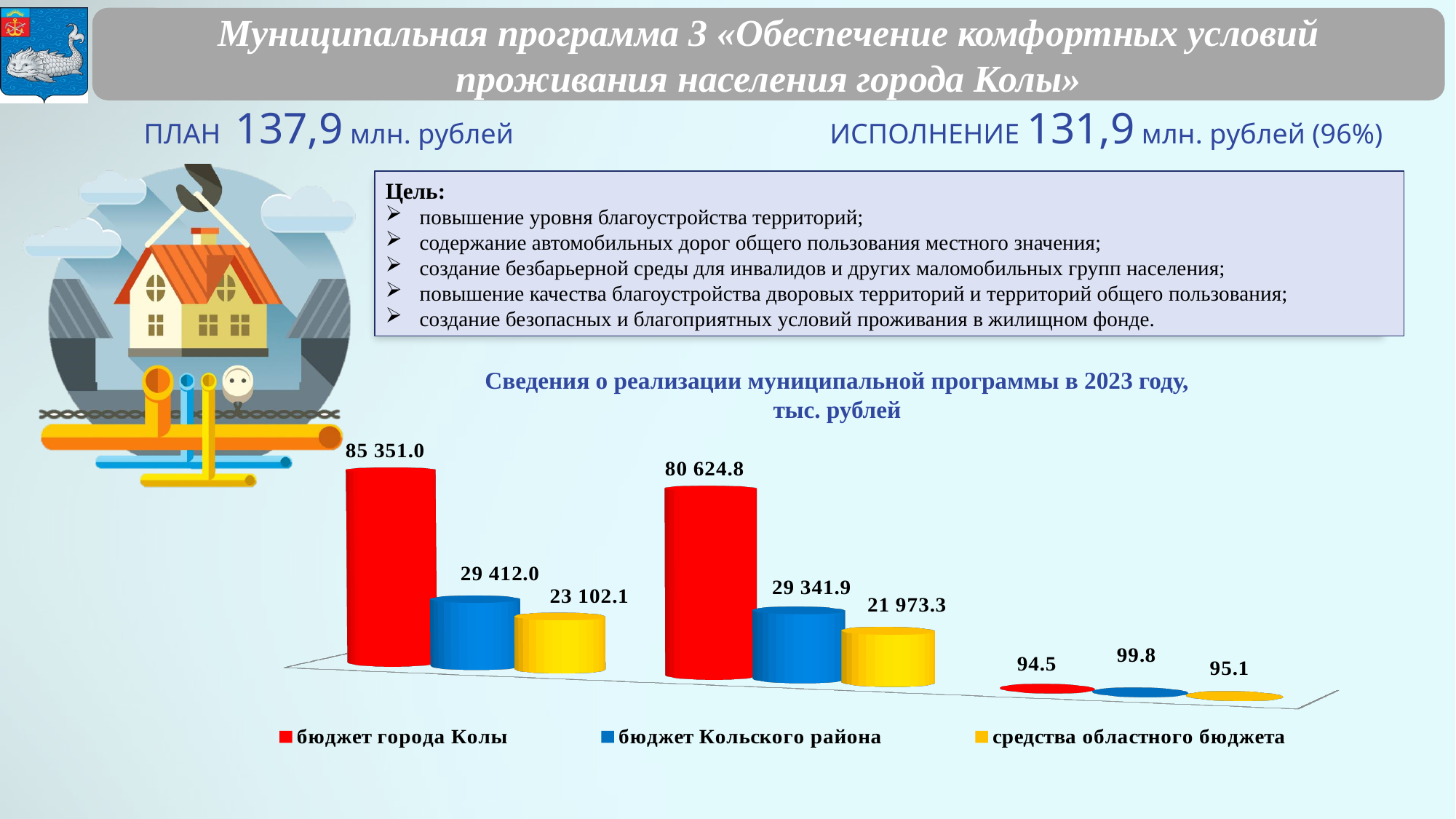
Which series has the highest value in the leftmost group of bars? бюджет города Колы Which series has the lowest value in the middle group of bars? средства областного бюджета What is the difference between the yellow bar in the leftmost group (23 102.1) and the yellow bar in the middle group (21 973.3)? 1 128.8 What is the value labelled for the blue series (бюджет Кольского района) in the rightmost group? 99.8 What colour represents бюджет города Колы in the chart? red In the leftmost group, which is larger: the blue bar (бюджет Кольского района) or the yellow bar (средства областного бюджета)? бюджет Кольского района What is the difference between the red bar in the leftmost group (85 351.0) and the red bar in the middle group (80 624.8)? 4 726.2 How many series does the chart legend list? 3 What kind of chart is shown on the slide? bar chart What is the value of the red bar (бюджет города Колы) in the leftmost group of bars? 85 351.0 What is the value of the blue bar (бюджет Кольского района) in the middle group of bars? 29 341.9 What is the value of the yellow bar (средства областного бюджета) in the leftmost group of bars? 23 102.1